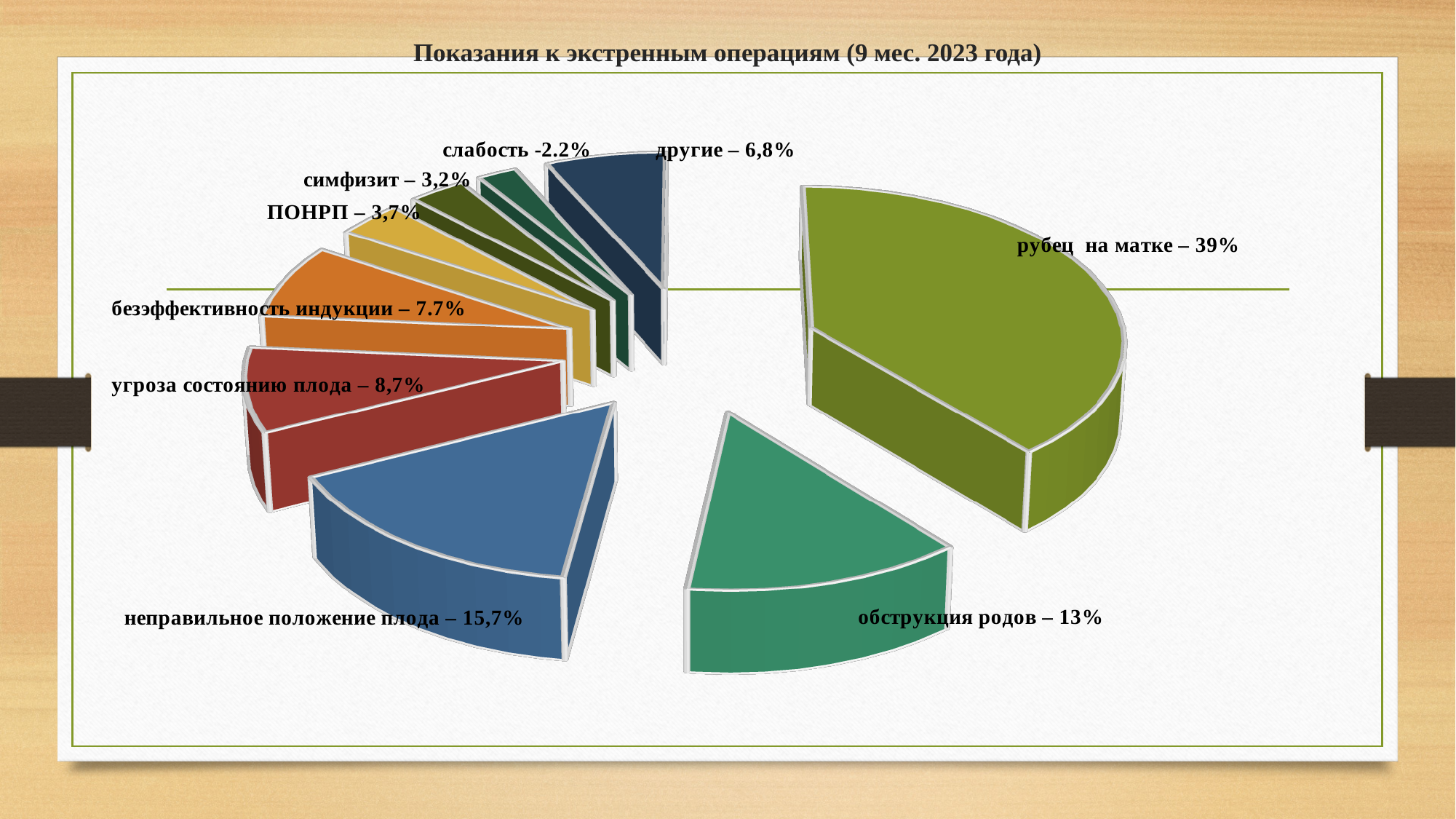
What is the share for "обструкция родов"? 13% What is the title of the chart? Показания к экстренным операциям (9 мес. 2023 года) What is the difference in percentage points between "рубец на матке" and "обструкция родов"? 26 What is the share for "рубец на матке"? 39% Which is larger: the share for "неправильное положение плода" or for "обструкция родов"? неправильное положение плода What is the share for "угроза состоянию плода"? 8,7% What type of chart is shown on the slide? pie chart What is the share for "неправильное положение плода"? 15,7% What is the share for "ПОНРП"? 3,7% How many slices does the pie chart have? 9 Which category has the largest share of the pie? рубец на матке Which category has the smallest share of the pie? слабость